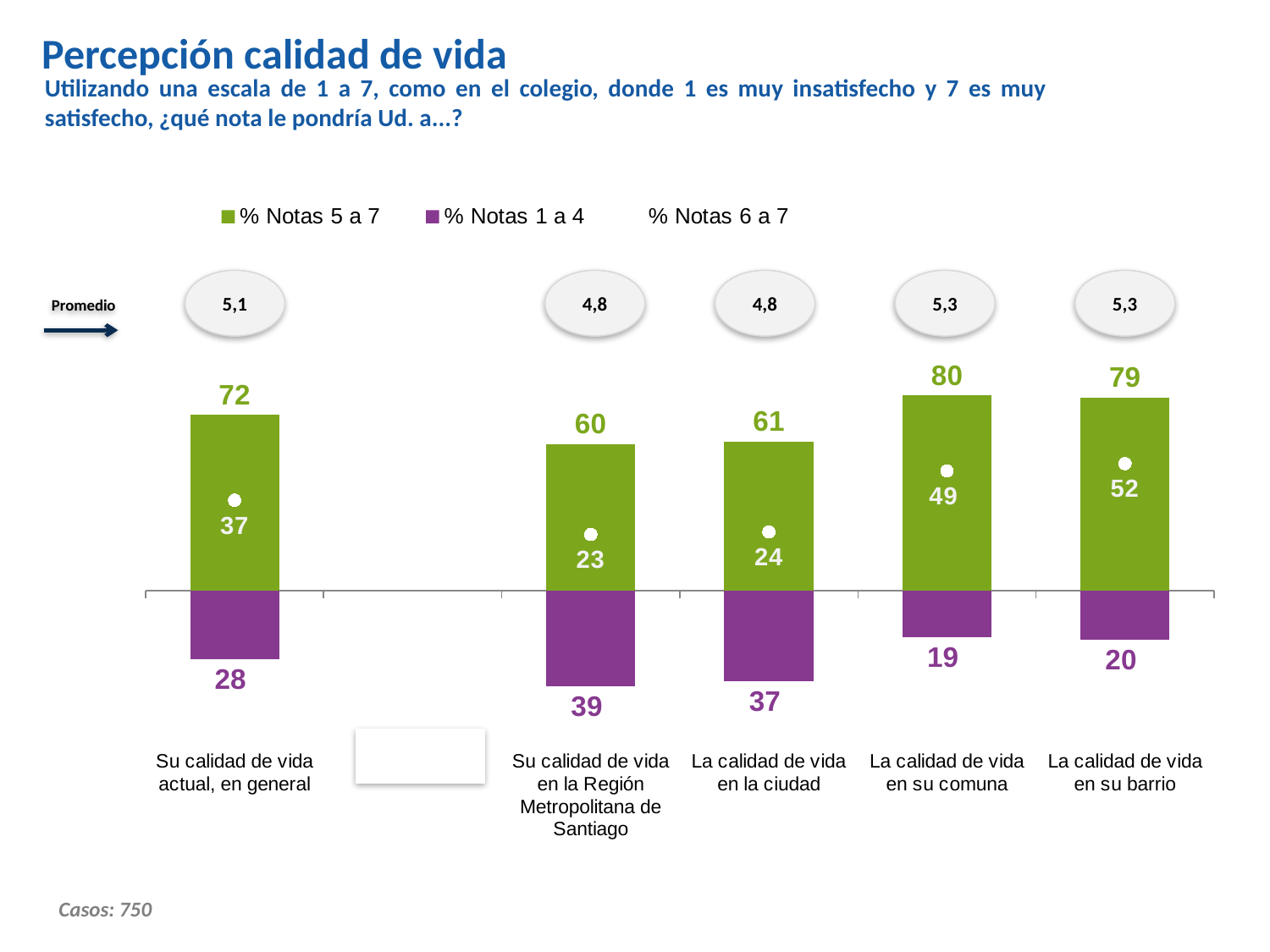
What is the value of % Notas 5 a 7 for "Su calidad de vida actual, en general"? 72 What is the Promedio shown for "La calidad de vida en la ciudad"? 4,8 Which is larger: the % Notas 6 a 7 value for "Su calidad de vida actual, en general" or for "La calidad de vida en la ciudad"? Su calidad de vida actual, en general Which category has the lowest value of % Notas 1 a 4? La calidad de vida en su comuna How many categories are plotted on the chart? 5 How many series does the legend list? 3 Which category has the highest value of % Notas 5 a 7? La calidad de vida en su comuna What is the value of % Notas 1 a 4 for "Su calidad de vida en la Región Metropolitana de Santiago"? 39 What is the value of % Notas 6 a 7 for "La calidad de vida en su barrio"? 52 What colour are the bars for % Notas 1 a 4? Purple What kind of chart is shown on the slide? Bar chart What is the difference between the % Notas 5 a 7 values for "La calidad de vida en su comuna" and "Su calidad de vida en la Región Metropolitana de Santiago"? 20